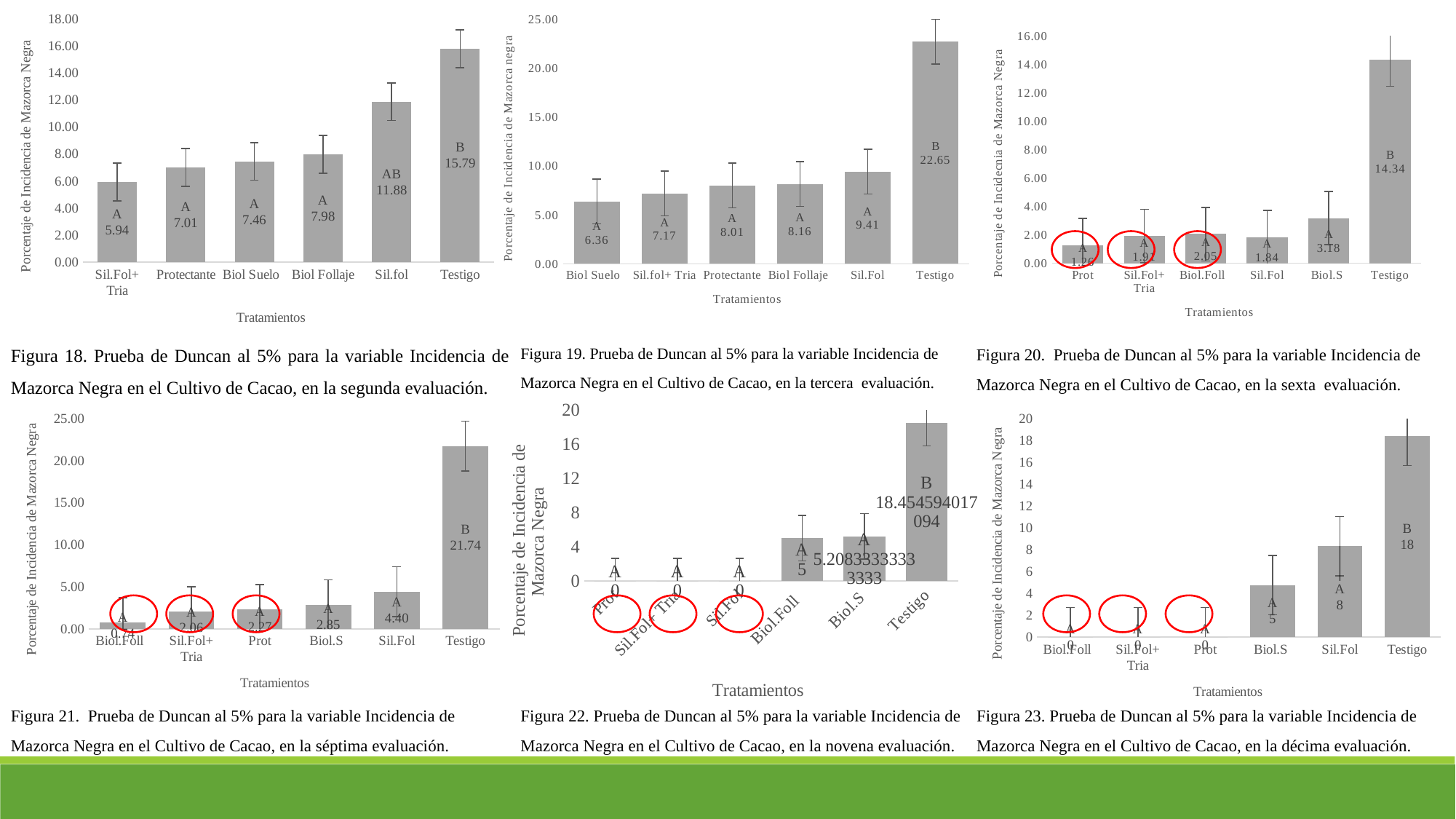
In Figura 18, what is the value for Testigo? 15.79 In Figura 21, which is larger, Biol.S or Sil.Fol? Sil.Fol In Figura 18, which treatment has the lowest value? Sil.Fol+ Tria In Figura 19, which treatment has the lowest value? Biol Suelo How many treatments are shown in Figura 23? 6 In Figura 20, what is the value for Biol.S? 3.18 In Figura 19, what is the difference between Testigo and Sil.Fol? 13.24 In Figura 21, what is the value for Testigo? 21.74 In Figura 20, which treatment has the highest value? Testigo In Figura 18, what is the value for Sil.fol? 11.88 In Figura 19, what is the value for Testigo? 22.65 In Figura 23, what is the value for Sil.Fol? 8